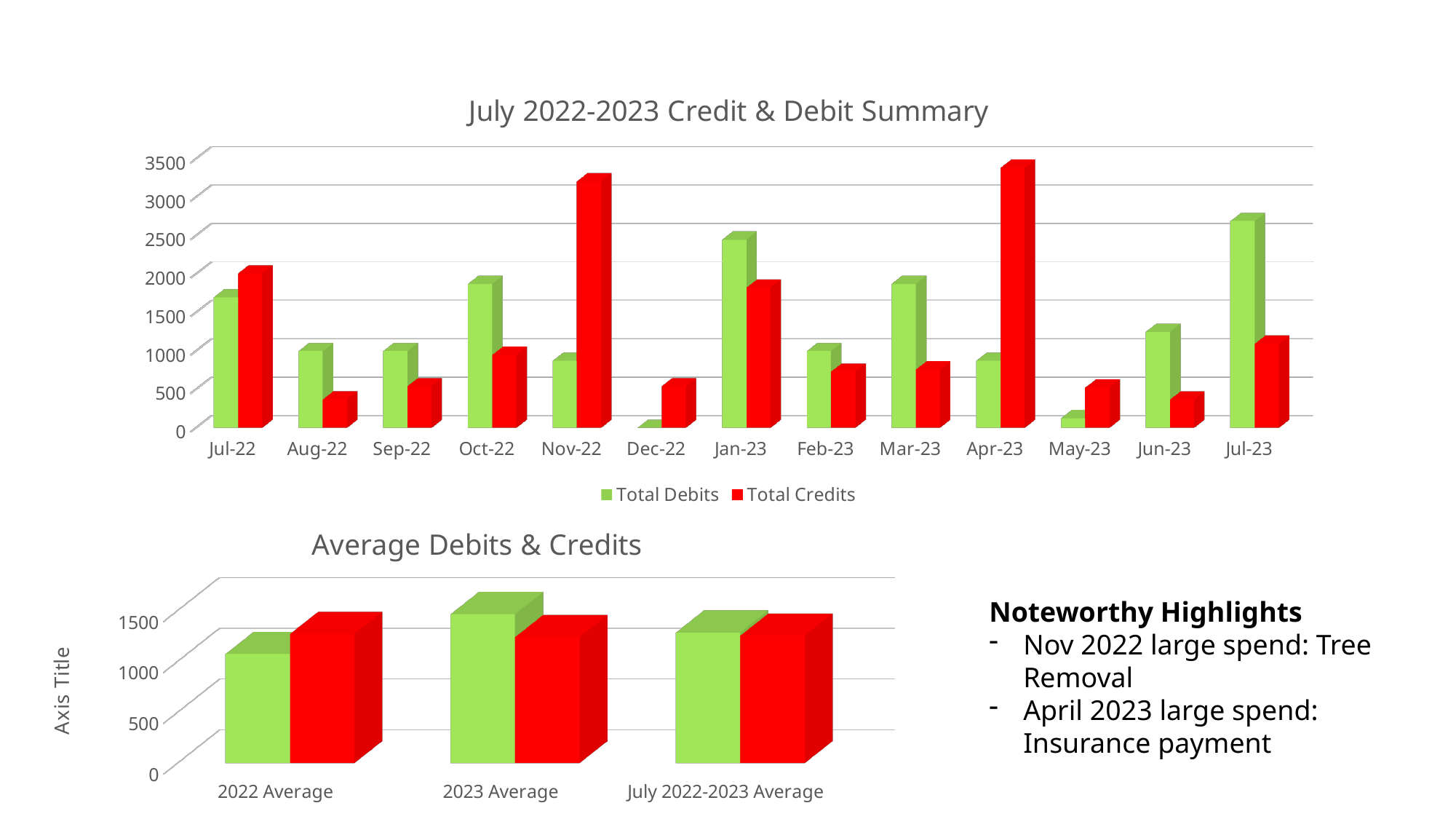
In the 'Average Debits & Credits' chart, how many categories are shown on the x axis? 3 In the 'July 2022-2023 Credit & Debit Summary' chart, how many months are shown on the x axis? 13 In the 'July 2022-2023 Credit & Debit Summary' chart, how many series does the legend list? 2 In the 'July 2022-2023 Credit & Debit Summary' chart, which month has the lowest Total Debits? Dec-22 In the 'July 2022-2023 Credit & Debit Summary' chart, which month has the highest Total Debits? Jul-23 In the 'July 2022-2023 Credit & Debit Summary' chart, which is larger for Mar-23, Total Debits or Total Credits? Total Debits In the 'July 2022-2023 Credit & Debit Summary' chart, which colour represents Total Credits? red In the 'July 2022-2023 Credit & Debit Summary' chart, is the Total Credits value for Nov-22 greater or less than 3000? greater In the 'July 2022-2023 Credit & Debit Summary' chart, what kind of chart is shown? bar chart In the 'Average Debits & Credits' chart, which is larger for 2023 Average, the green (debits) bar or the red (credits) bar? green (debits) In the 'July 2022-2023 Credit & Debit Summary' chart, which month has the highest Total Credits? Apr-23 In the 'July 2022-2023 Credit & Debit Summary' chart, is the Total Debits value for Jan-23 greater or less than 2000? greater